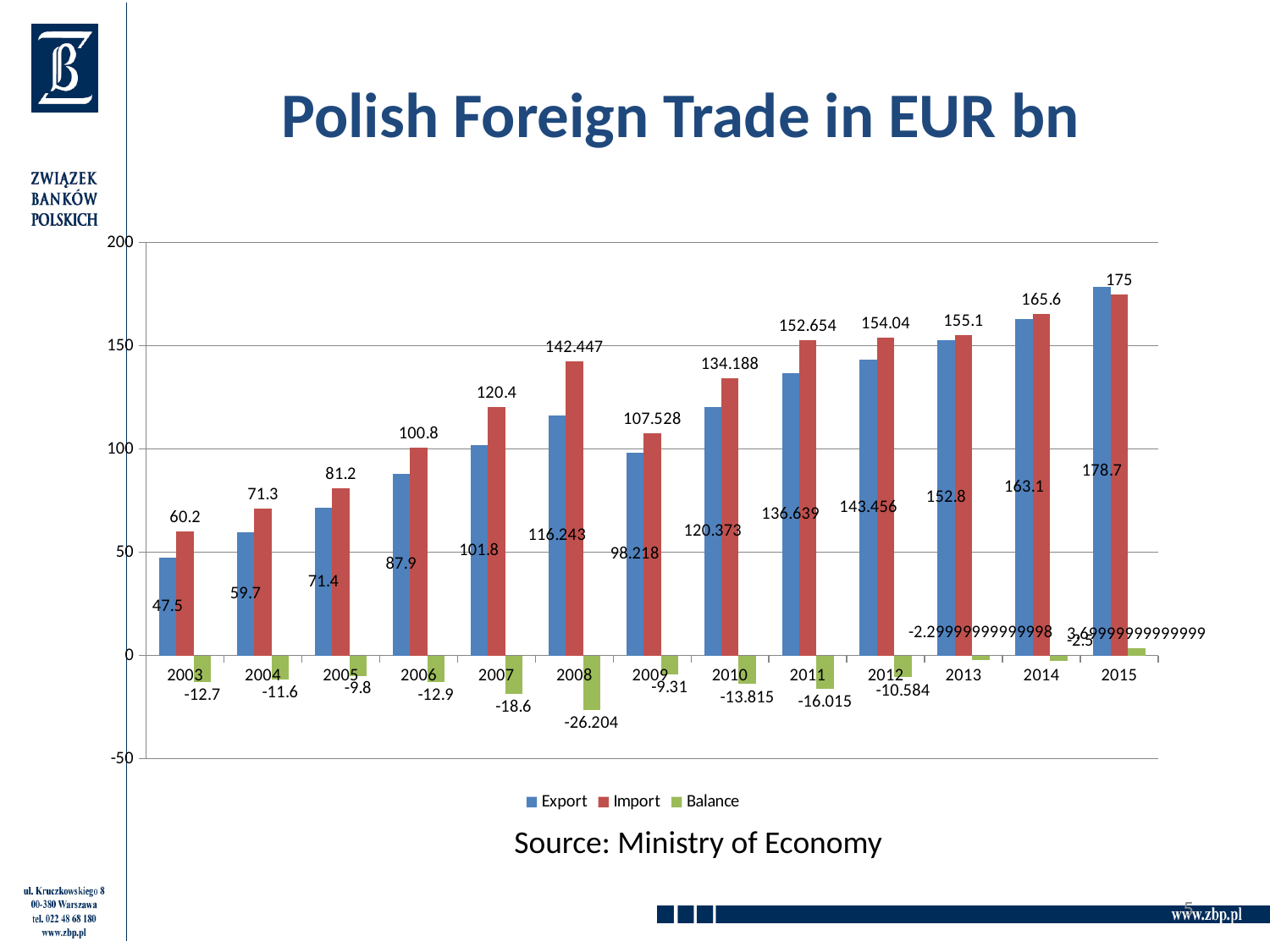
What is the Balance value for 2010? -13.815 What is the Export value for 2003? 47.5 In which year is Export the highest? 2015 In 2009, which is larger, Export or Import? Import In which year is the Balance the lowest? 2008 How many series does the legend list? 3 What is the difference between the Export values for 2014 and 2013? 10.3 What is the Import value for 2008? 142.447 Does the Import value rise or fall from 2003 to 2008? rise Is the Export value for 2011 greater or less than 150? less What kind of chart is shown on the slide? bar chart How many years are shown on the x axis? 13